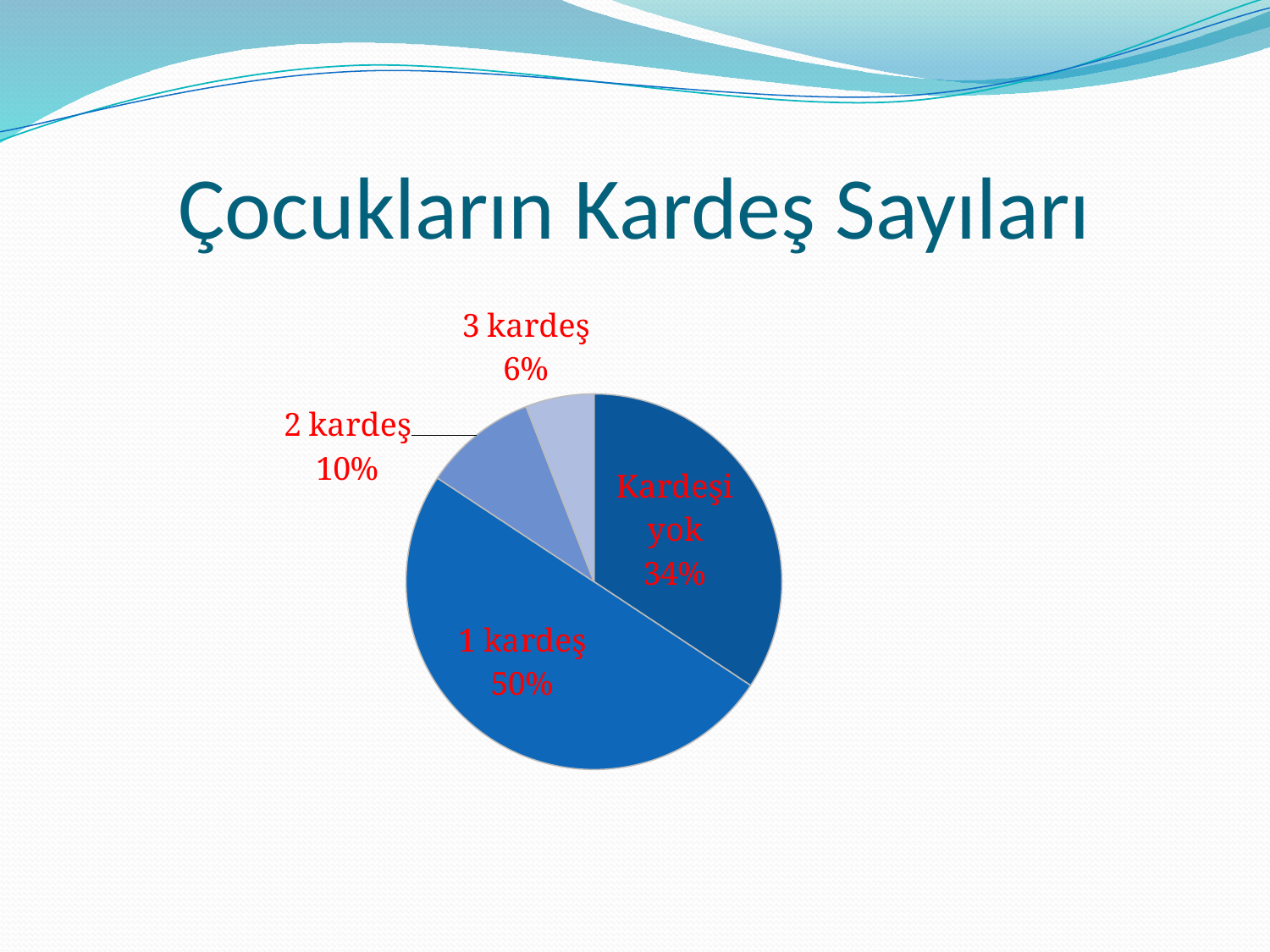
What is the combined share of 2 kardeş and 3 kardeş? 16% What kind of chart is shown on the slide? pie chart What percentage is shown for 2 kardeş? 10% What percentage is shown for 3 kardeş? 6% How many slices does the pie chart have? 4 What is the title of the slide containing the chart? Çocukların Kardeş Sayıları What is the difference in percentage points between 1 kardeş and Kardeşi yok? 16 What percentage of children have 1 kardeş (one sibling)? 50% What percentage is shown for Kardeşi yok? 34% Which category has the largest share of the pie? 1 kardeş Which category has the smallest share of the pie? 3 kardeş Which is larger, the share for 2 kardeş or the share for 3 kardeş? 2 kardeş